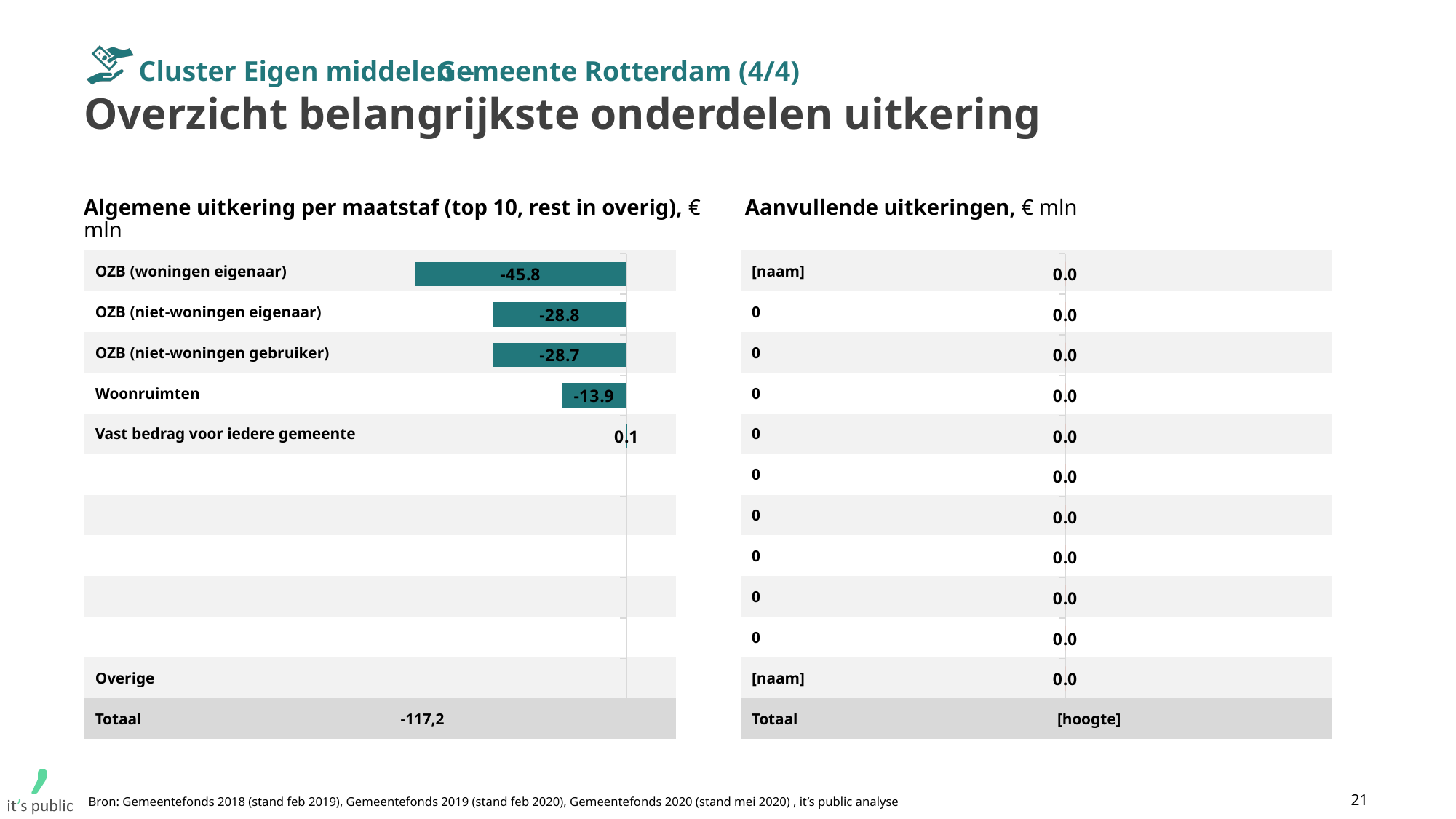
In the chart 'Algemene uitkering per maatstaf', which category has the lowest (most negative) value? OZB (woningen eigenaar) In the chart 'Algemene uitkering per maatstaf', how many categories have a labelled value bar? 5 In the chart 'Algemene uitkering per maatstaf', what is the difference between the values for OZB (woningen eigenaar) and OZB (niet-woningen eigenaar)? 17.0 In the chart 'Algemene uitkering per maatstaf', which is larger in magnitude: OZB (woningen eigenaar) or Woonruimten? OZB (woningen eigenaar) In the chart 'Algemene uitkering per maatstaf', what is the value for OZB (woningen eigenaar)? -45.8 In the chart 'Algemene uitkering per maatstaf', what is the value for Woonruimten? -13.9 What kind of chart is 'Algemene uitkering per maatstaf'? Bar chart In the chart 'Algemene uitkering per maatstaf', what is the value for Vast bedrag voor iedere gemeente? 0.1 What unit is stated in the title of the chart 'Aanvullende uitkeringen'? € mln In the chart 'Algemene uitkering per maatstaf', what is the value for OZB (niet-woningen gebruiker)? -28.7 In the chart 'Algemene uitkering per maatstaf', what is the Totaal shown at the bottom? -117,2 In the chart 'Algemene uitkering per maatstaf', which category has the highest value? Vast bedrag voor iedere gemeente